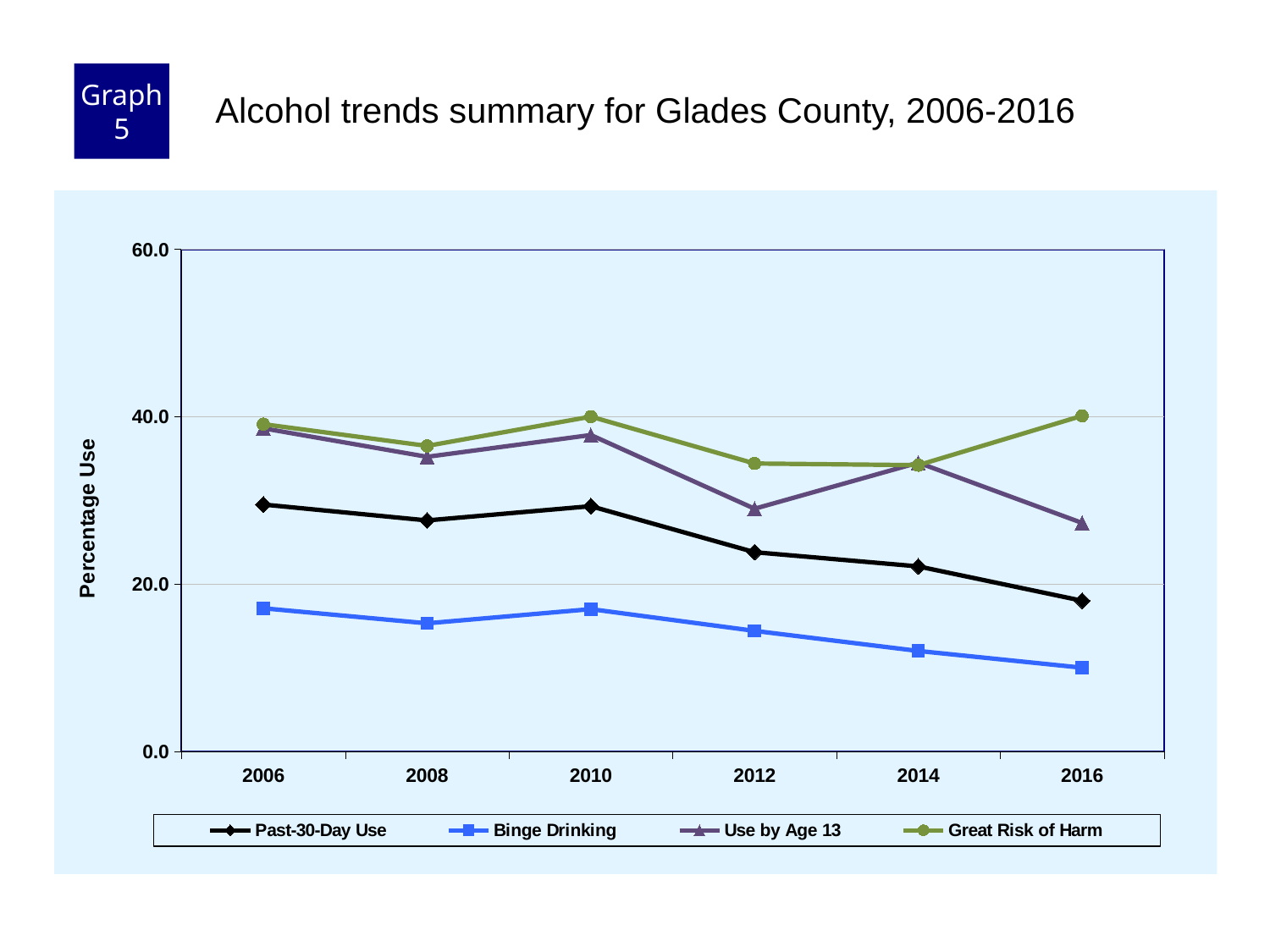
In 2016, which series has the higher value: Great Risk of Harm or Use by Age 13? Great Risk of Harm Is the value for Binge Drinking in 2016 greater or less than 20.0? less Is the value for Use by Age 13 in 2012 greater or less than 40.0? less In which year is Binge Drinking at its lowest? 2016 Is the value for Past-30-Day Use in 2006 greater or less than 20.0? greater What is the label on the y axis? Percentage Use Which series has the highest value in 2016? Great Risk of Harm Does Binge Drinking rise or fall from 2010 to 2016? fall How many years are plotted along the x axis? 6 How many series does the legend list? 4 What kind of chart is shown on the slide? line chart